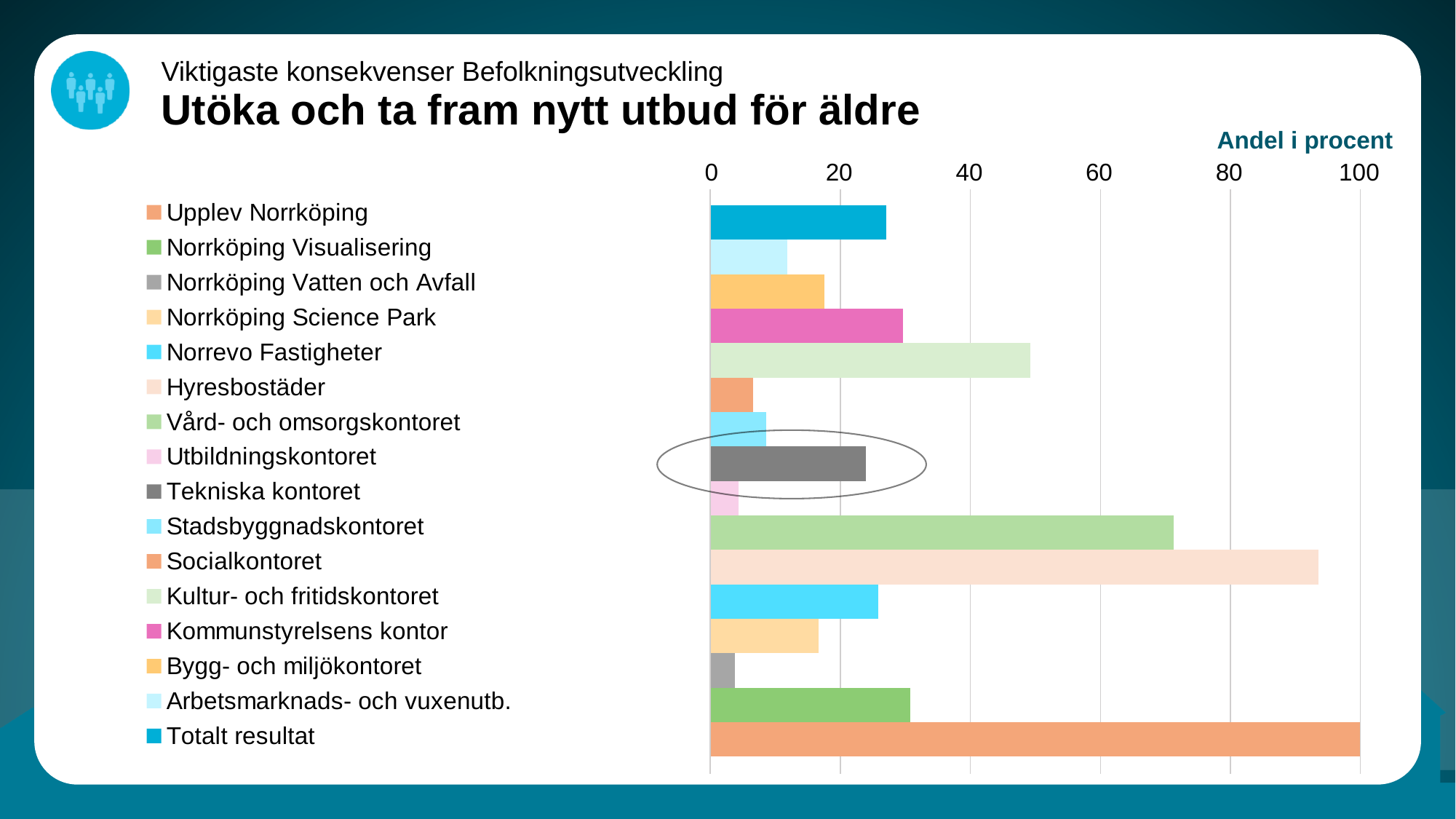
How many categories are listed in the chart's legend? 16 What is the value for Upplev Norrköping? 100 Which is larger, the value for Hyresbostäder or the value for Vård- och omsorgskontoret? Hyresbostäder What kind of chart is shown on the slide? bar chart Is the value for Socialkontoret greater or less than 20? less Which is larger, the value for Kommunstyrelsens kontor or the value for Socialkontoret? Kommunstyrelsens kontor Is the value for Vård- och omsorgskontoret greater or less than 60? greater Is the value for Hyresbostäder greater or less than 80? greater Which category has the highest value in the chart? Upplev Norrköping What label is shown above the chart's horizontal axis? Andel i procent